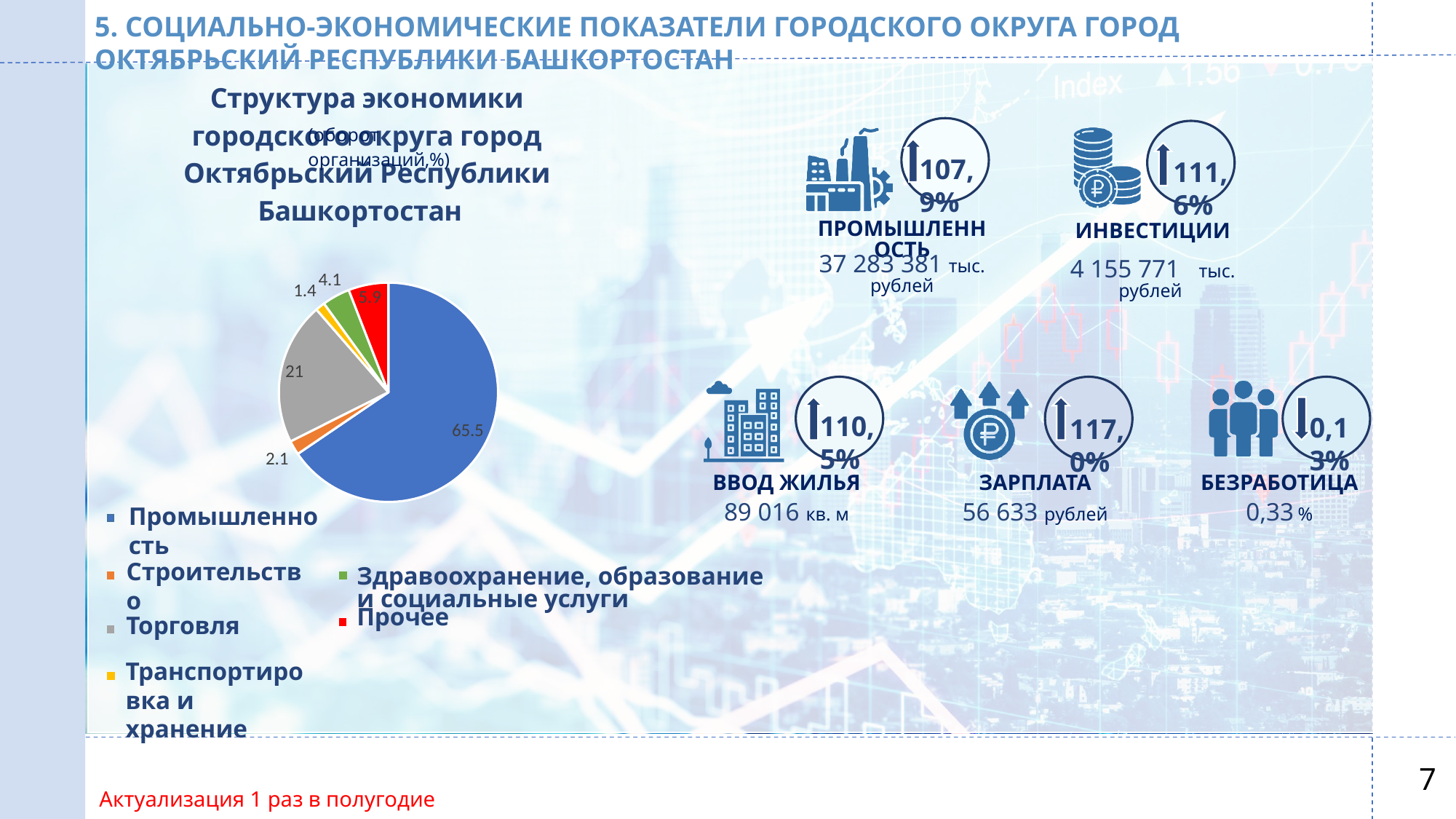
How many slices does the pie chart have? 6 What colour is the Торговля slice in the pie chart? gray Which category has the largest slice in the pie chart? Промышленность What is the value for Строительство in the pie chart? 2.1 What kind of chart is shown on the slide? pie chart What is the difference between the values for Промышленность and Торговля in the pie chart? 44.5 What is the value for Транспортировка и хранение in the pie chart? 1.4 What is the value for Торговля in the pie chart? 21 Which category has the smallest slice in the pie chart? Транспортировка и хранение What is the value for Прочее in the pie chart? 5.9 Which is larger in the pie chart: Прочее or Здравоохранение, образование и социальные услуги? Прочее What is the value for Промышленность in the pie chart? 65.5